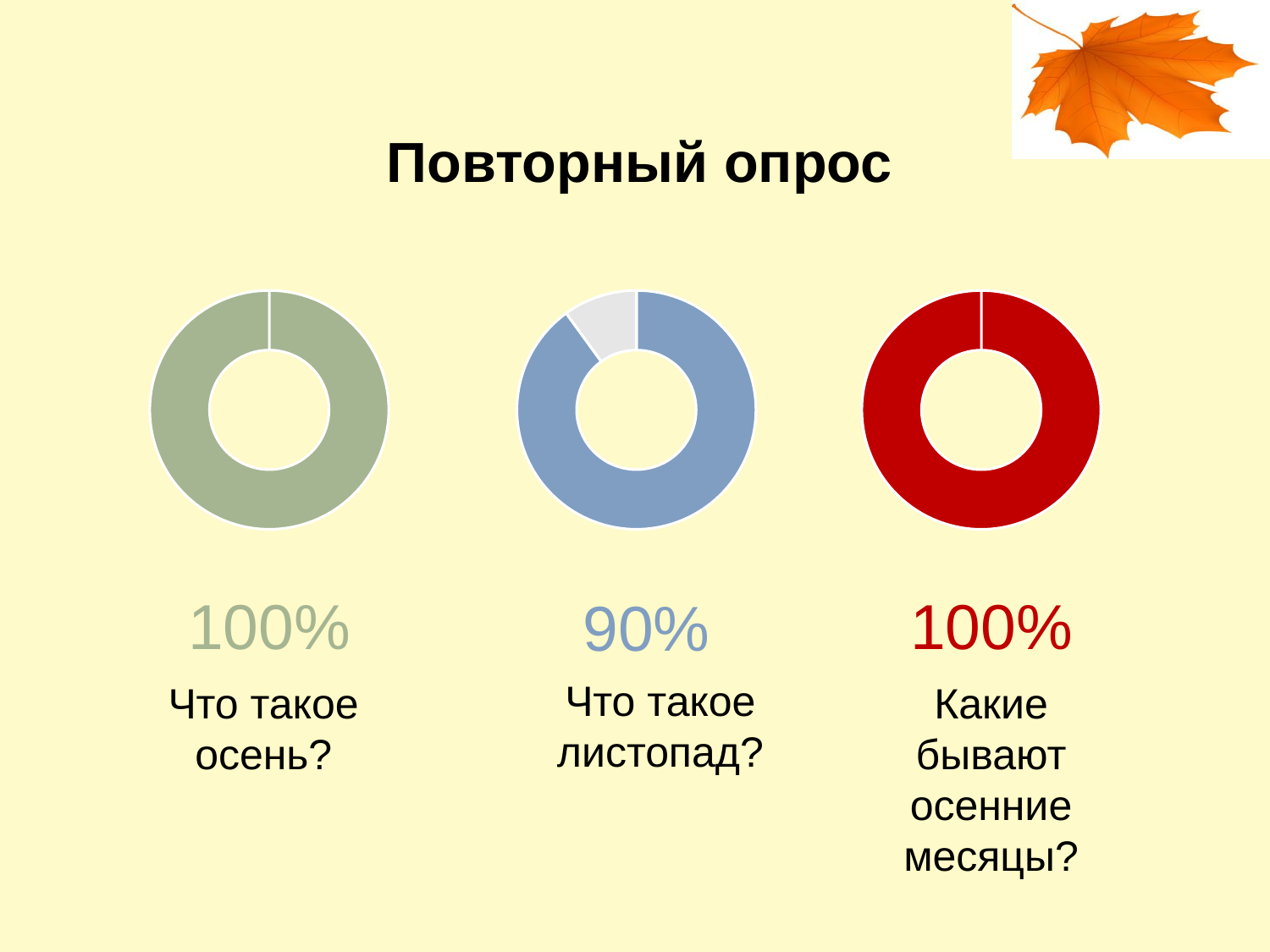
How many charts are shown on the slide? 3 What kind of chart is used for each of the three questions on the slide? Donut (pie) chart What percentage is shown for the chart labelled "Что такое осень?"? 100% What is the difference between the percentage for "Что такое осень?" and the percentage for "Что такое листопад?"? 10% What percentage is shown for the chart labelled "Какие бывают осенние месяцы?"? 100% In the middle chart ("Что такое листопад?"), what share of the ring is not filled in blue? 10% What colour is the ring of the chart labelled "Какие бывают осенние месяцы?"? Red What percentage is shown for the chart labelled "Что такое листопад?"? 90% What is the title of the slide? Повторный опрос Is the percentage for "Что такое листопад?" greater or less than 50%? greater Which is larger: the percentage for "Что такое осень?" or for "Что такое листопад?"? Что такое осень? Which question has the lowest percentage shown? Что такое листопад?